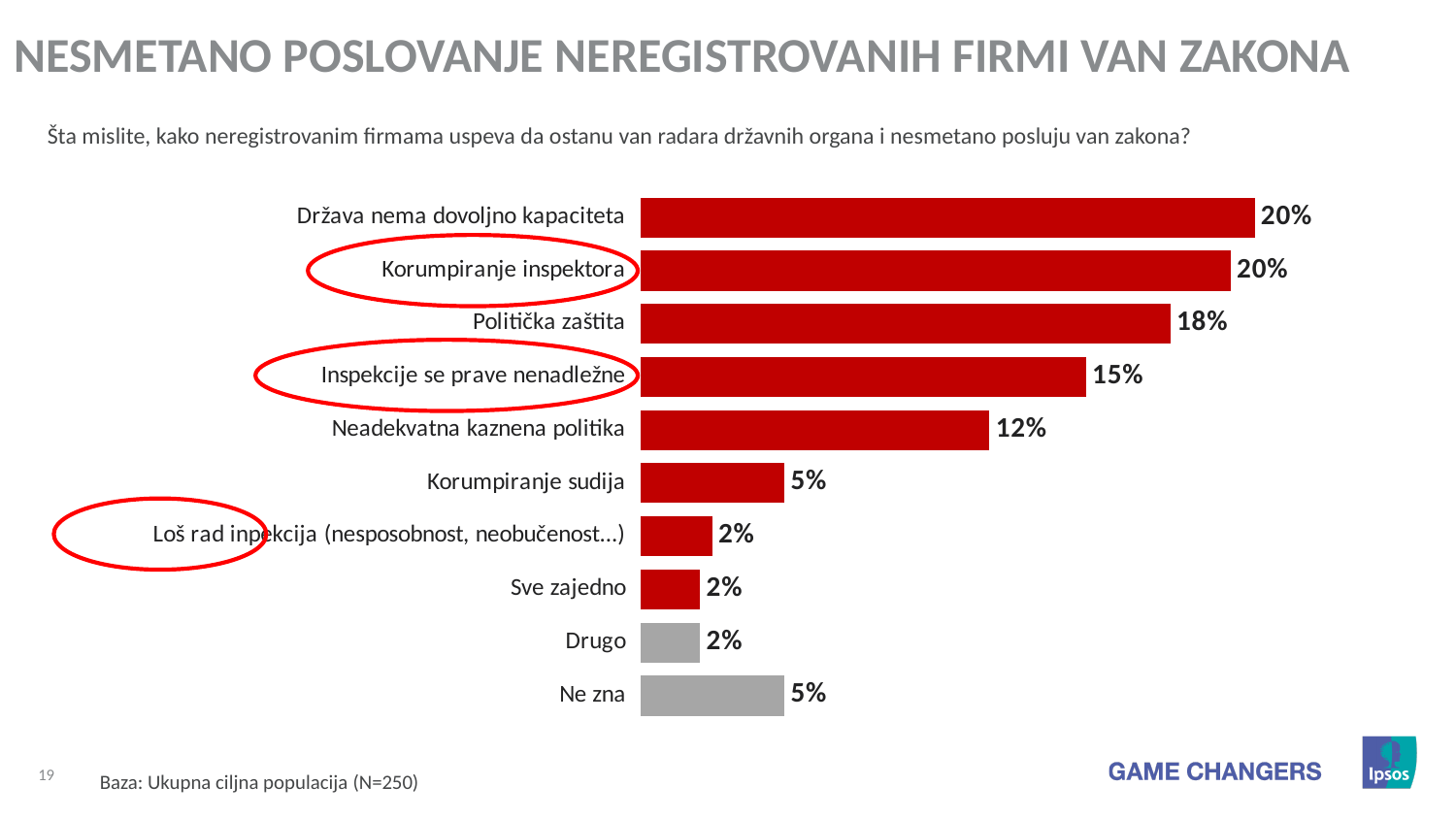
What value is shown for "Korumpiranje sudija"? 5% Which is larger, the value for "Politička zaštita" or for "Neadekvatna kaznena politika"? Politička zaštita What percentage is shown for "Ne zna"? 5% Which two categories have grey bars instead of red ones? Drugo and Ne zna What kind of chart is shown on the slide? Bar chart What value is shown for "Država nema dovoljno kapaciteta"? 20% What percentage is shown for "Neadekvatna kaznena politika"? 12% How many categories are shown in the chart? 10 What is the difference in percentage points between "Politička zaštita" and "Neadekvatna kaznena politika"? 6 percentage points What value is shown for "Inspekcije se prave nenadležne"? 15% What is the difference in percentage points between "Korumpiranje inspektora" and "Korumpiranje sudija"? 15 percentage points What percentage is shown for "Politička zaštita"? 18%